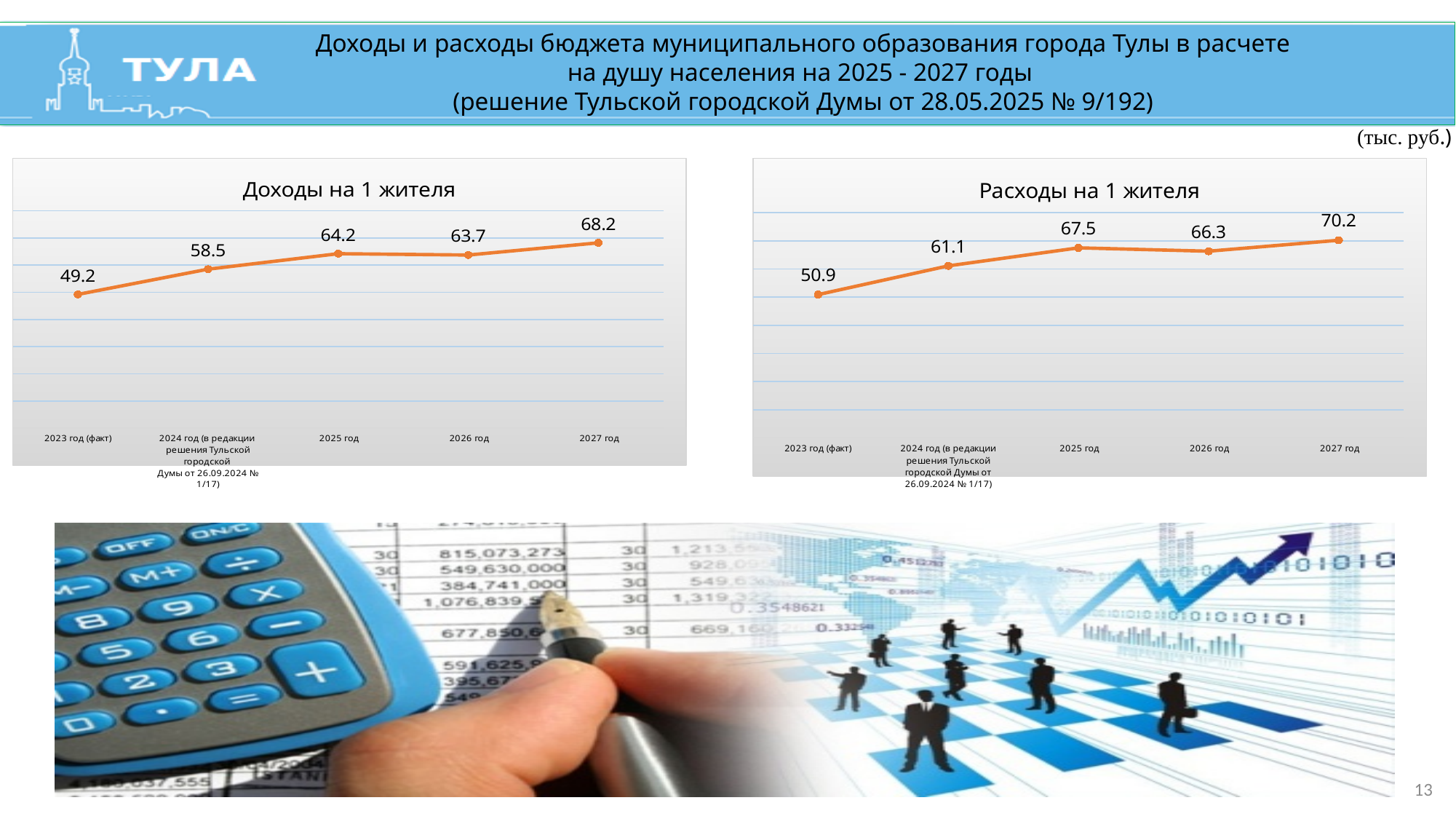
In the chart 'Расходы на 1 жителя', do the values generally rise or fall from 2023 to 2027? Rise How many data points are plotted in the chart 'Доходы на 1 жителя'? 5 In the chart 'Расходы на 1 жителя', which year has the lowest value? 2023 год (факт) In the chart 'Расходы на 1 жителя', what is the difference between the values for 2025 год and 2026 год? 1.2 In the chart 'Доходы на 1 жителя', which is larger: the value for 2025 год or 2026 год? 2025 год What is the title of the left chart on the slide? Доходы на 1 жителя In the chart 'Расходы на 1 жителя', what is the value for 2023 год (факт)? 50.9 In the chart 'Расходы на 1 жителя', which is larger: the value for 2024 год or 2027 год? 2027 год In the chart 'Доходы на 1 жителя', what is the value for 2025 год? 64.2 In the chart 'Доходы на 1 жителя', which year has the highest value? 2027 год What type of chart is 'Расходы на 1 жителя'? Line chart In the chart 'Доходы на 1 жителя', what is the difference between the values for 2027 год and 2023 год (факт)? 19.0